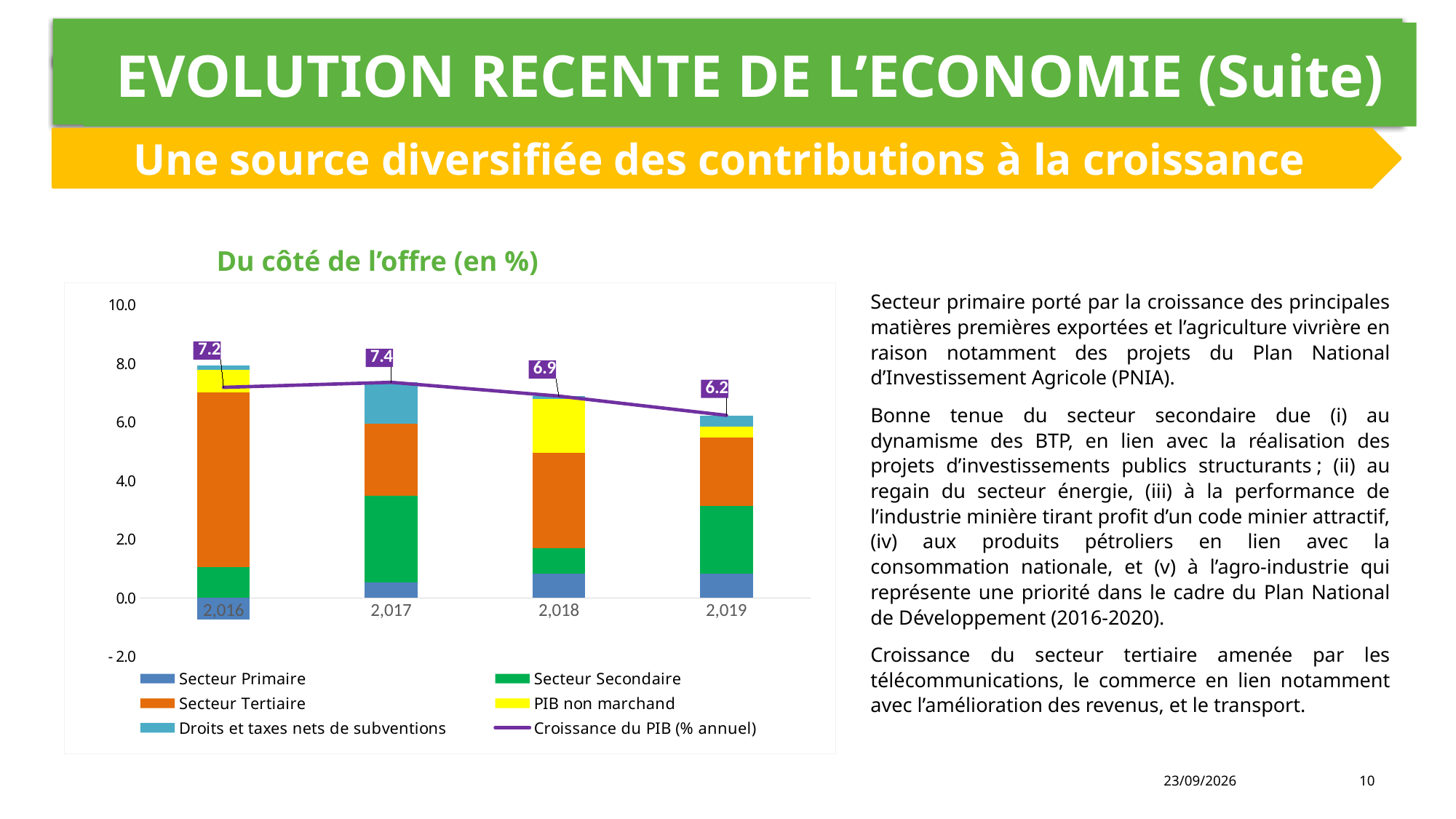
Which year has the larger Croissance du PIB (% annuel), 2,016 or 2,018? 2,016 What is the value of Croissance du PIB (% annuel) for 2,019? 6.2 Does Croissance du PIB (% annuel) rise or fall from 2,017 to 2,019? Fall How many years are shown on the x axis of the chart? 4 In which year is Croissance du PIB (% annuel) highest? 2,017 How many series does the chart legend list? 6 In which year is Croissance du PIB (% annuel) lowest? 2,019 What is the value of Croissance du PIB (% annuel) for 2,016? 7.2 What is the value of Croissance du PIB (% annuel) for 2,017? 7.4 What kind of chart is shown on the slide? Stacked bar chart with a line Is the Secteur Tertiaire value for 2,016 greater or less than 4.0? greater What is the difference between Croissance du PIB (% annuel) in 2,017 and in 2,019? 1.2